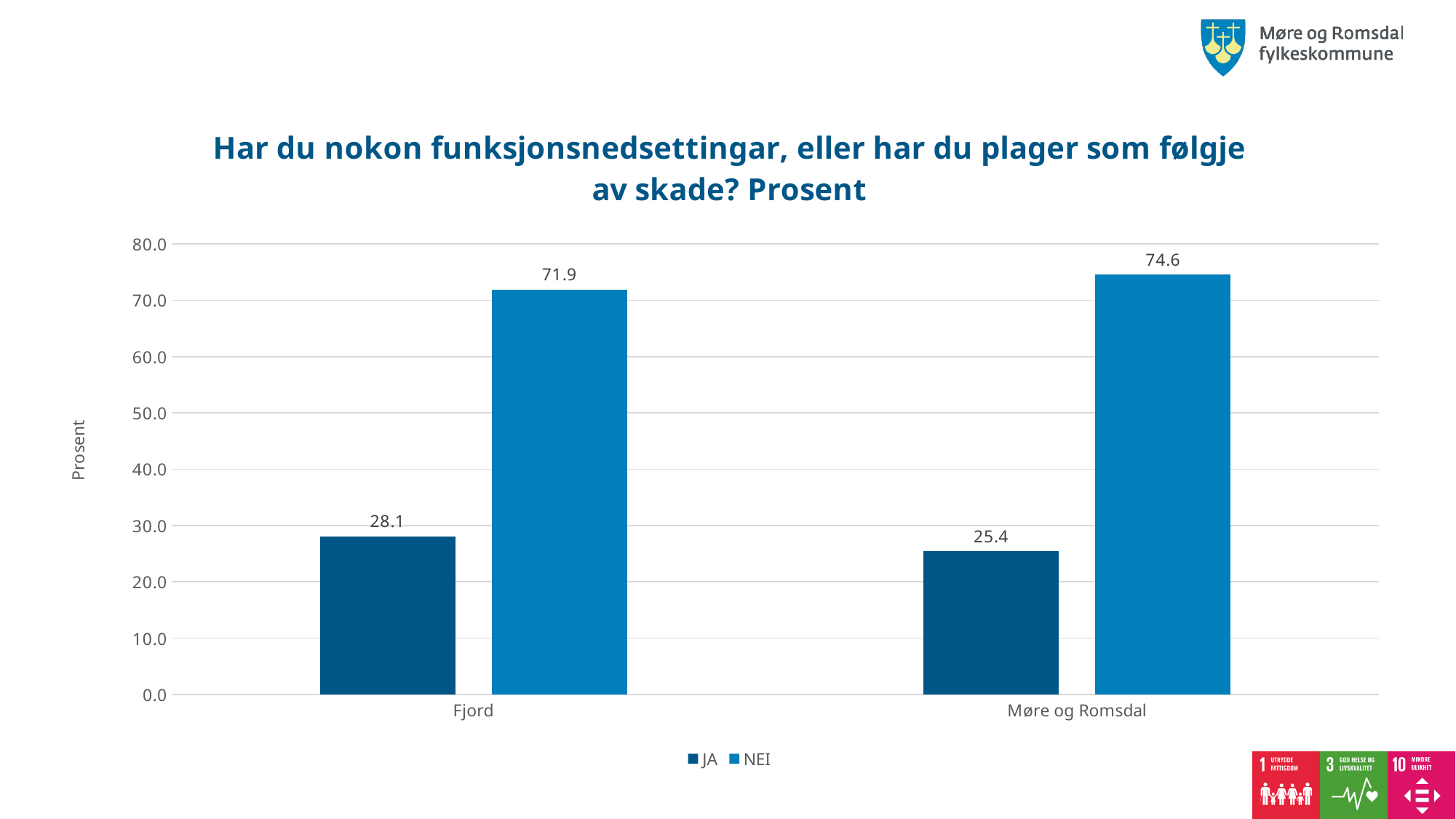
Is the JA value for Fjord greater or less than the JA value for Møre og Romsdal? greater How many categories are shown on the x axis? 2 What is the NEI value for Møre og Romsdal? 74.6 How many series does the legend list? 2 What is the difference between the JA values for Fjord and Møre og Romsdal? 2.7 What is the JA value for Møre og Romsdal? 25.4 What kind of chart is shown on the slide? bar chart What is the JA value for Fjord? 28.1 Which category has the higher NEI value? Møre og Romsdal Which category has the lower JA value? Møre og Romsdal What is the NEI value for Fjord? 71.9 What is the difference between the NEI values for Møre og Romsdal and Fjord? 2.7